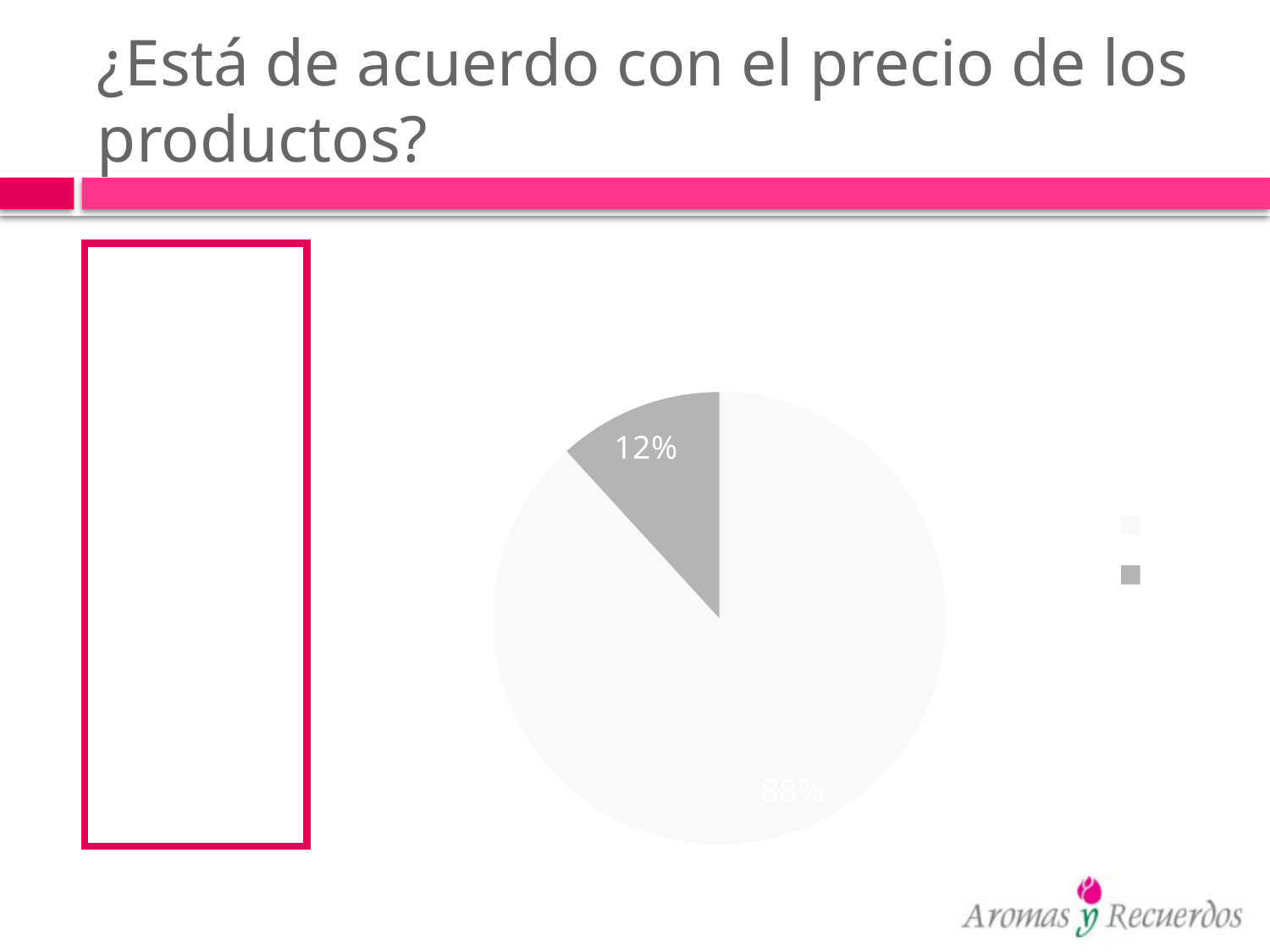
Which slice of the pie chart is the smallest? the grey slice (12%) What is the difference in percentage points between the two slices of the pie chart? 76 Is the grey slice or the light-coloured slice of the pie chart larger? the light-coloured slice What question does the slide title ask above the pie chart? ¿Está de acuerdo con el precio de los productos? Which slice of the pie chart is the largest? the light-coloured slice (88%) What percentage is shown on the grey slice of the pie chart? 12% How many slices does the pie chart have? 2 How many entries does the legend of the pie chart list? 2 What share of the pie does the grey slice represent? 12% What kind of chart is shown on the slide? pie chart What percentage is shown on the large light-coloured slice of the pie chart? 88%